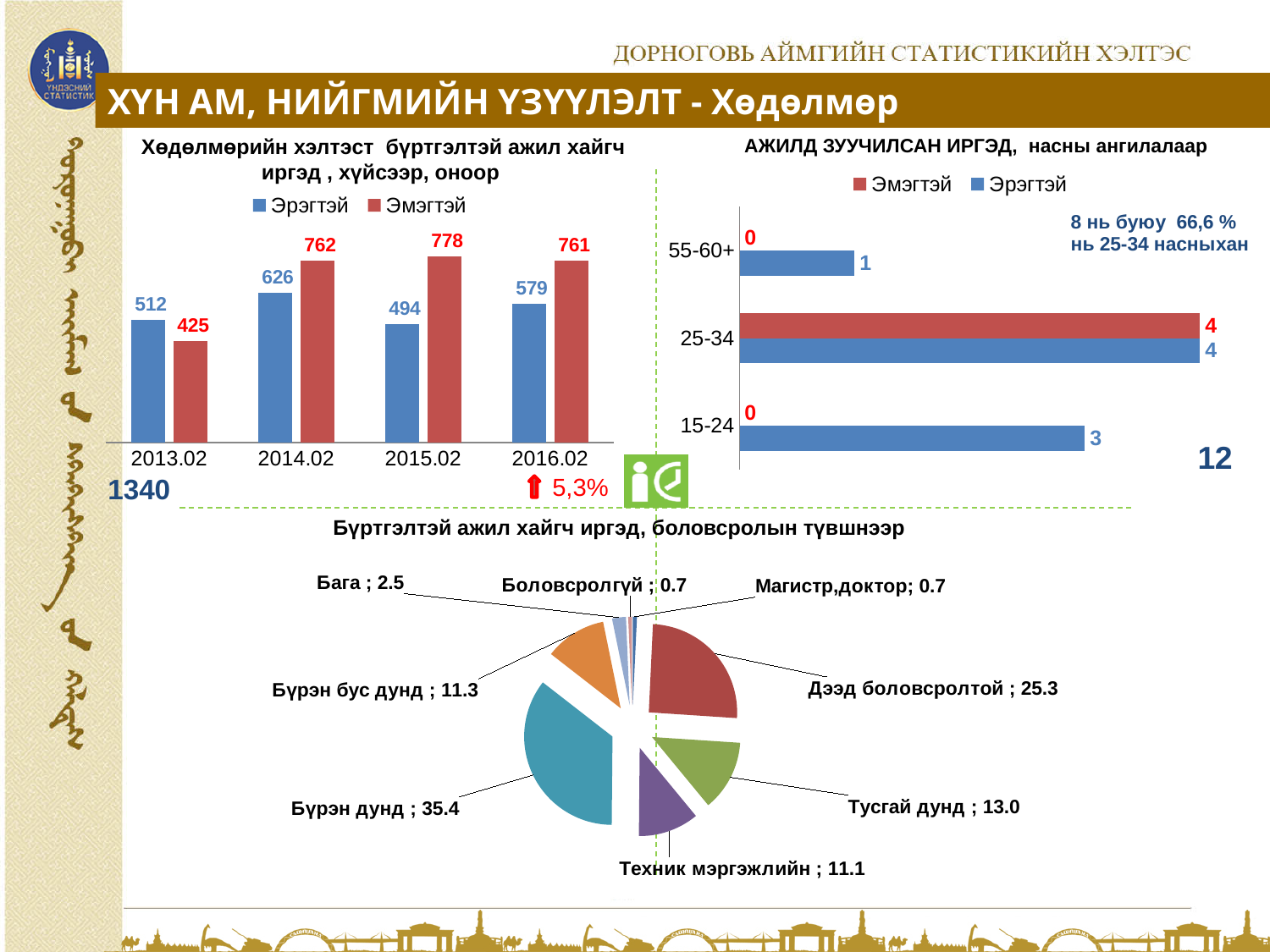
In the top-right chart (АЖИЛД ЗУУЧИЛСАН ИРГЭД, насны ангилалаар), what is the Эрэгтэй value for the 15-24 age group? 3 In the pie chart (Бүртгэлтэй ажил хайгч иргэд, боловсролын түвшнээр), what is the value for Бүрэн дунд? 35.4 What kind of chart is the top-left chart on the slide? bar chart In the top-left bar chart, what is the difference between the Эмэгтэй and Эрэгтэй values in 2014.02? 136 In the top-left bar chart (Хөдөлмөрийн хэлтэст бүртгэлтэй ажил хайгч иргэд), what is the value for Эмэгтэй in 2015.02? 778 In the top-left bar chart, what is the value for Эрэгтэй in 2013.02? 512 In the top-right chart, what is the total of the Эмэгтэй and Эрэгтэй values for the 25-34 age group? 8 In the top-left bar chart, in which year is the Эмэгтэй value highest? 2015.02 How many series does the legend of the top-right chart list? 2 In the top-left bar chart, which series has the larger value in 2013.02, Эрэгтэй or Эмэгтэй? Эрэгтэй In the pie chart, which education level has the largest slice? Бүрэн дунд How many year categories are shown on the x axis of the top-left bar chart? 4